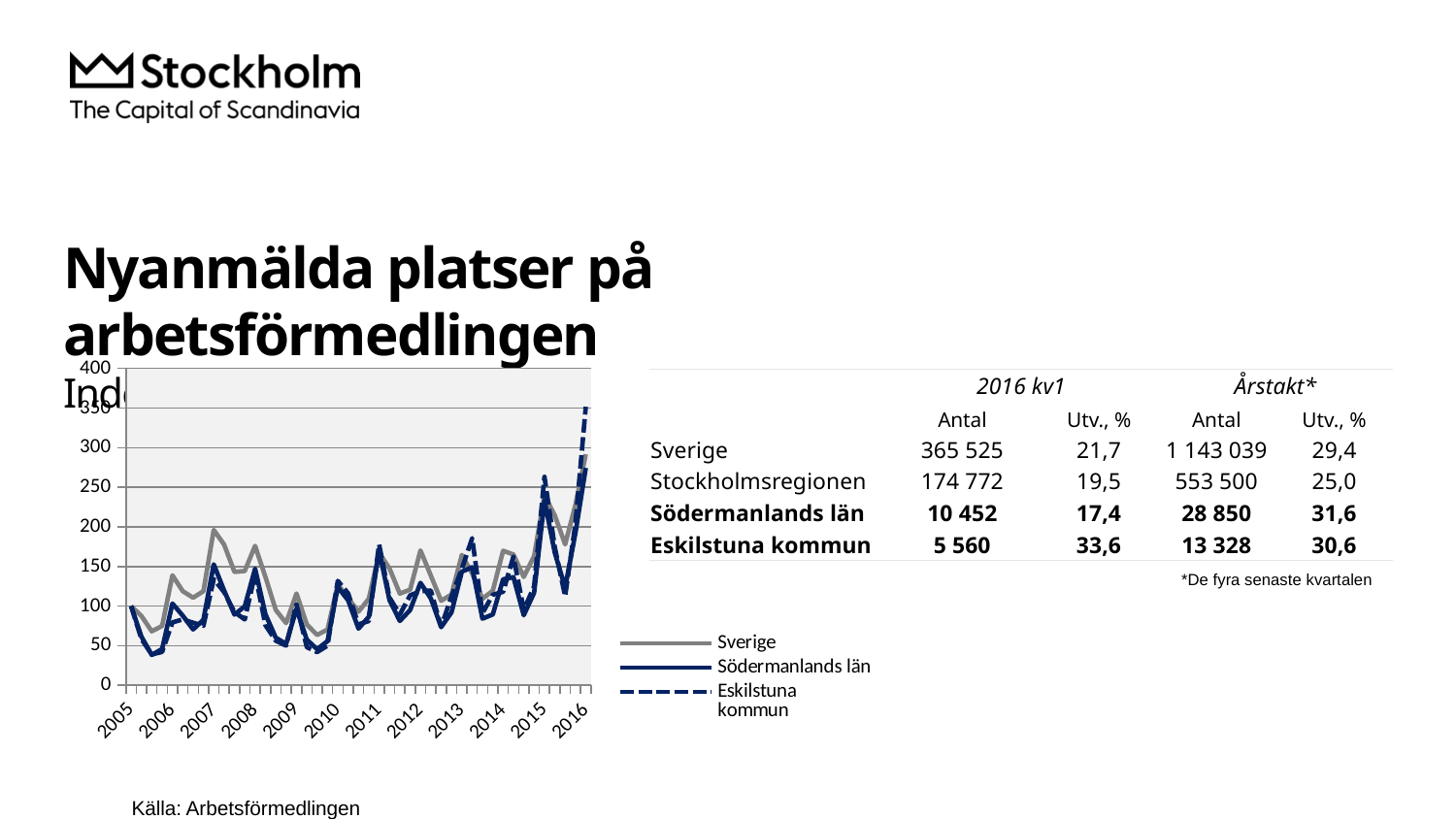
Which series in the chart is drawn with a dashed line? Eskilstuna kommun Do the values in the chart generally rise or fall from 2015 to 2016? rise Is the value for Sverige at the start of 2005 greater or less than 150? less What is the first year shown on the chart's x axis? 2005 What kind of chart is shown on the slide? line chart Is the lowest value for Södermanlands län around 2005–2006 greater or less than 100? less Is the peak value for Sverige around 2007 greater or less than 150? greater Which series reaches the highest value at the right end of the chart in 2016? Eskilstuna kommun How many series does the chart's legend list? 3 At the end of 2016, is the value for Eskilstuna kommun larger or smaller than the value for Sverige? larger How many year labels are shown on the chart's x axis? 12